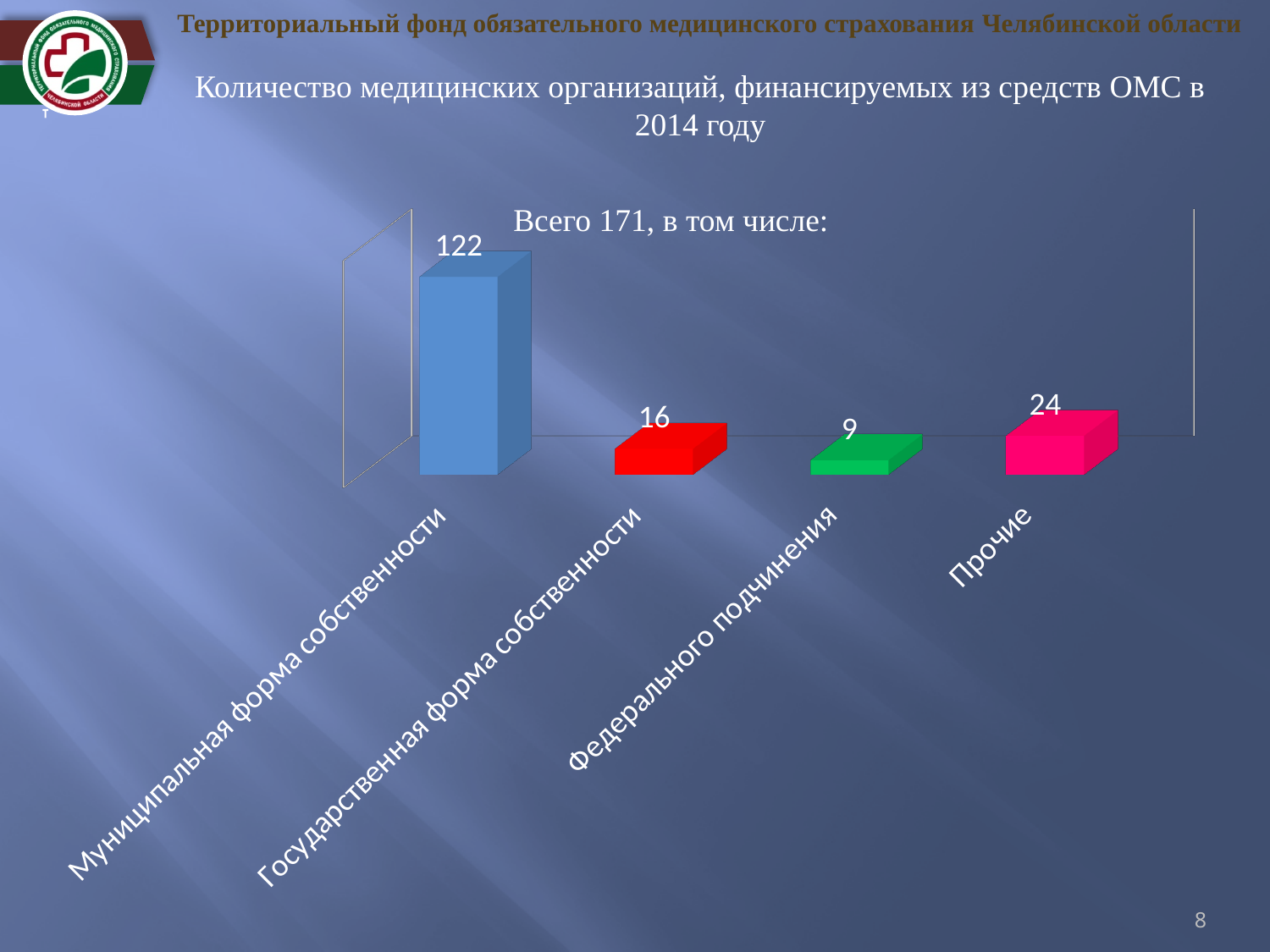
What is the difference between the values for Прочие and Государственная форма собственности? 8 Which is larger, the value for Прочие or the value for Государственная форма собственности? Прочие What total number of medical organisations does the chart's label state (Всего)? 171 What kind of chart is shown on the slide? Bar chart What is the value for Государственная форма собственности? 16 What is the value for Муниципальная форма собственности? 122 What is the value for Прочие? 24 What is the value for Федерального подчинения? 9 How many categories are shown in the chart? 4 Which category has the highest value? Муниципальная форма собственности Which category has the lowest value? Федерального подчинения What is the difference between the values for Муниципальная форма собственности and Прочие? 98